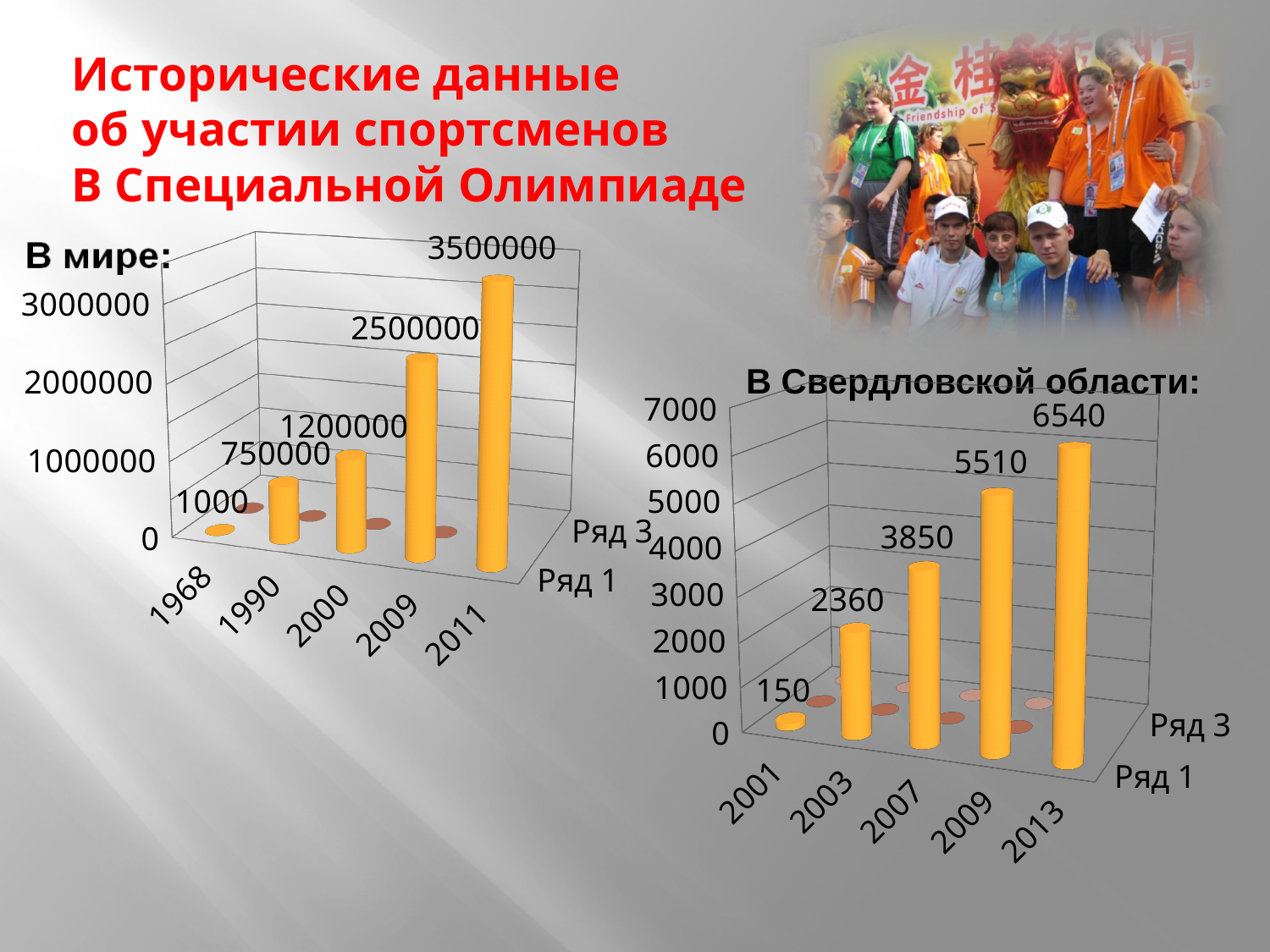
In the chart titled "В мире:", do the values rise or fall from 1968 to 2011? rise What kind of chart is the chart titled "В Свердловской области:"? bar chart In the chart titled "В Свердловской области:", what is the value for 2001? 150 In the chart titled "В мире:", what is the value for 2011? 3500000 In the chart titled "В мире:", what is the value for 1990? 750000 In the chart titled "В мире:", which year has the lowest value? 1968 In the chart titled "В мире:", what is the difference between the values for 2011 and 2009? 1000000 In the chart titled "В Свердловской области:", what is the difference between the values for 2013 and 2009? 1030 In the chart titled "В Свердловской области:", which is larger, the value for 2003 or the value for 2007? 2007 In the chart titled "В мире:", how many years are shown on the x axis? 5 In the chart titled "В Свердловской области:", what is the value for 2007? 3850 In the chart titled "В Свердловской области:", which year has the highest value? 2013